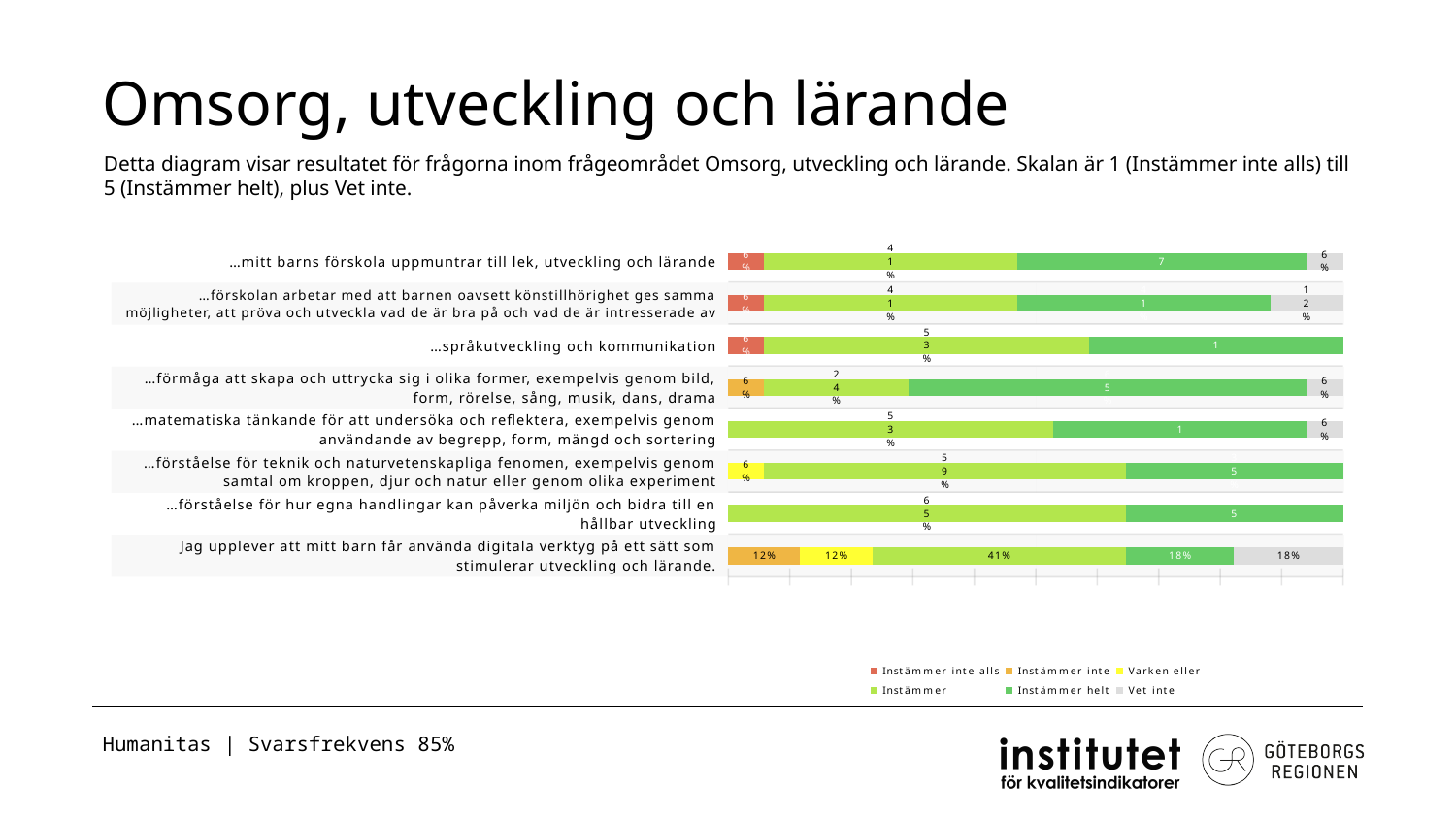
For the statement "Jag upplever att mitt barn får använda digitala verktyg på ett sätt som stimulerar utveckling och lärande.", what is the value for Instämmer inte? 12% For the statement about digitala verktyg (the bottom bar), which is larger: Instämmer or Instämmer helt? Instämmer What is the label of the first (top) category in the chart? …mitt barns förskola uppmuntrar till lek, utveckling och lärande How many series does the legend list? 6 For the statement "Jag upplever att mitt barn får använda digitala verktyg på ett sätt som stimulerar utveckling och lärande.", what is the value for Vet inte? 18% What kind of chart is shown on the slide? Stacked bar chart For the statement about digitala verktyg (the bottom bar), which response category has the largest share? Instämmer Which colour represents Vet inte in the legend? Grey For the statement "Jag upplever att mitt barn får använda digitala verktyg på ett sätt som stimulerar utveckling och lärande.", what is the value for Instämmer helt? 18% How many question statements (categories) are plotted in the chart? 8 For the statement "Jag upplever att mitt barn får använda digitala verktyg på ett sätt som stimulerar utveckling och lärande.", what is the value for Instämmer? 41% For the statement about digitala verktyg (the bottom bar), what is the difference between the Instämmer value and the Vet inte value? 23 percentage points